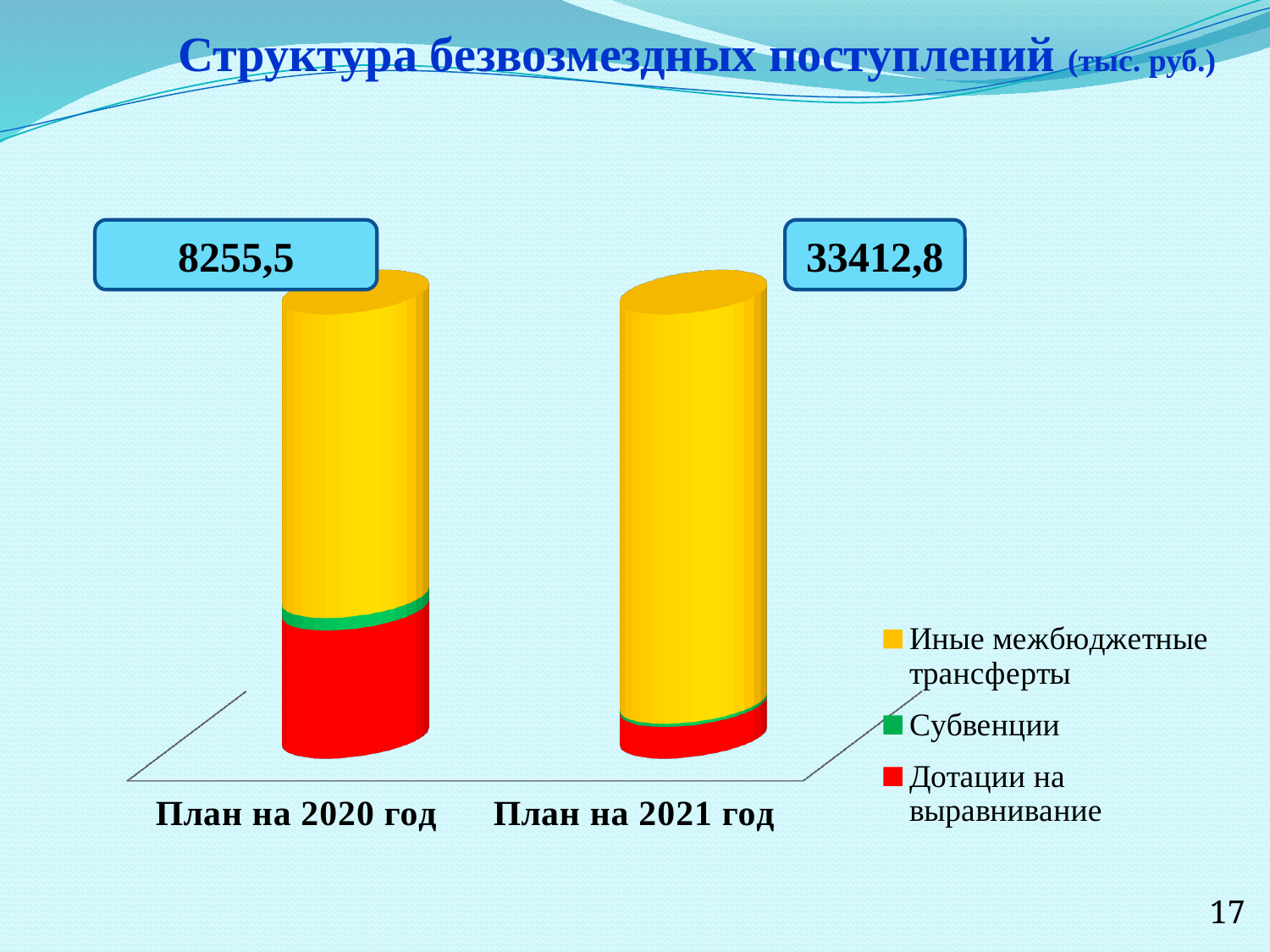
What is the title of the chart? Структура безвозмездных поступлений (тыс. руб.) How many series does the legend list? 3 What kind of chart is shown on the slide? Stacked bar chart Which series makes up the smallest part of the bar for План на 2020 год? Субвенции What total value is shown for План на 2021 год? 33412,8 What total value is shown for План на 2020 год? 8255,5 In which year does Дотации на выравнивание take a larger share of the bar, План на 2020 год or План на 2021 год? План на 2020 год What is the difference between the totals for План на 2021 год and План на 2020 год? 25157,3 What colour represents Субвенции in the chart? Green Which series makes up the largest part of the bar for План на 2021 год? Иные межбюджетные трансферты How many categories (bars) does the chart show? 2 Which has the larger total, План на 2020 год or План на 2021 год? План на 2021 год